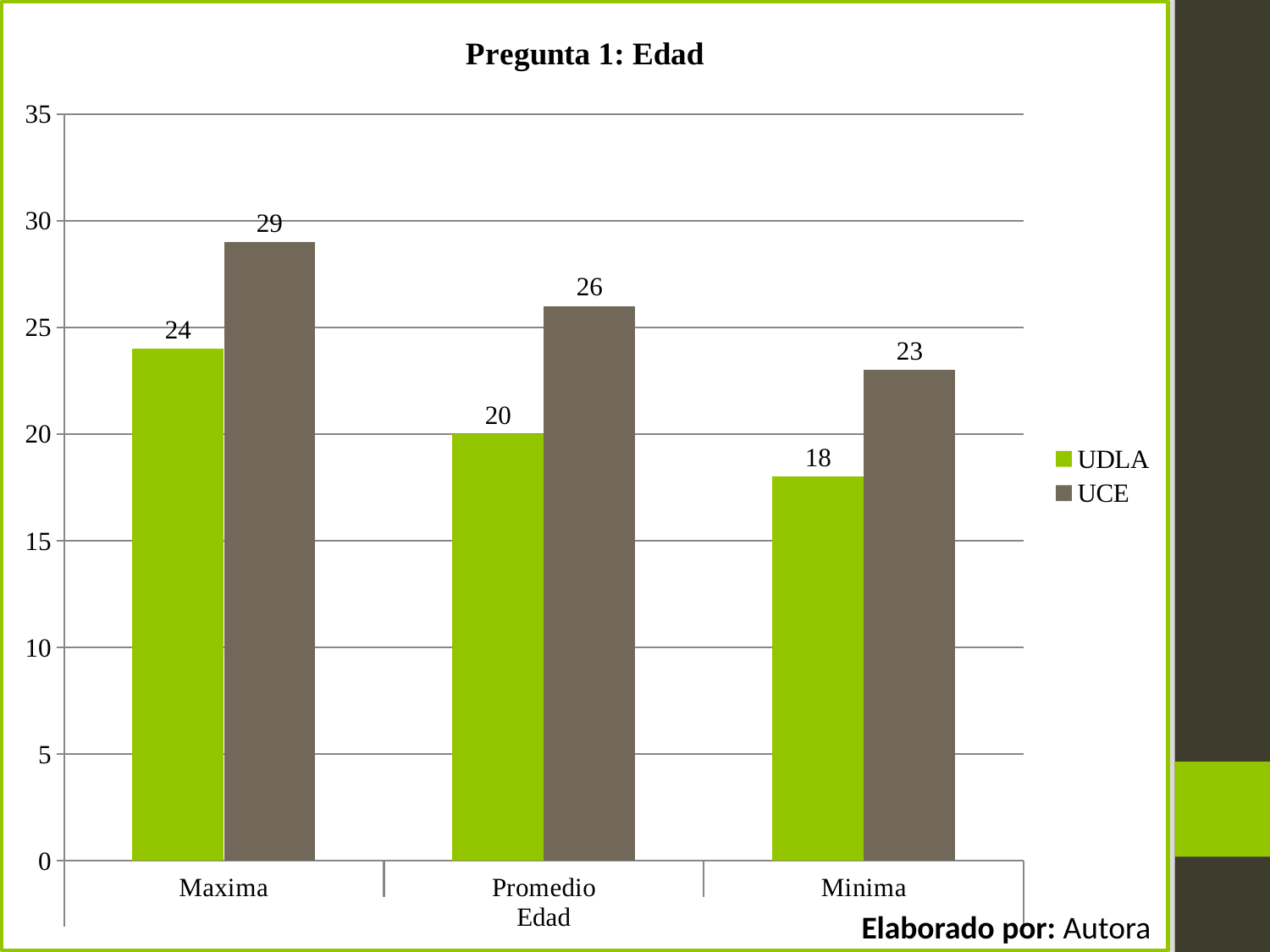
Which category has the lowest UDLA value? Minima How many categories are shown on the x axis? 3 What is the difference between the UCE and UDLA values for Maxima? 5 What is the UCE value for Promedio? 26 What kind of chart is shown? Bar chart What is the difference between the UCE values for Promedio and Minima? 3 What is the title of the chart? Pregunta 1: Edad Which is larger, the UDLA value for Promedio or the UCE value for Minima? UCE value for Minima Which category has the highest UCE value? Maxima How many series does the legend list? 2 What is the UDLA value for Maxima? 24 What is the UDLA value for Minima? 18